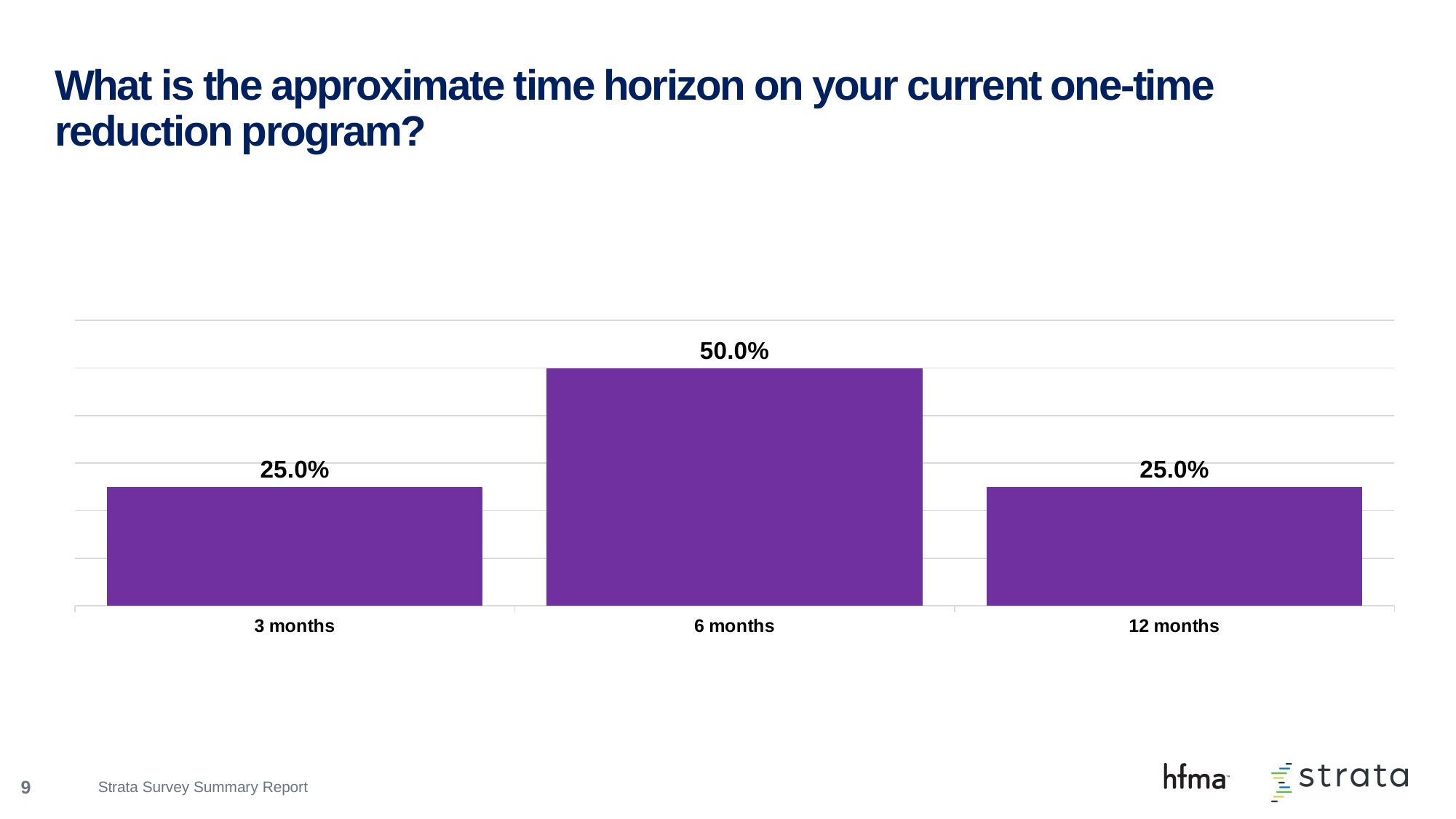
How many categories are shown on the x axis? 3 What colour are the bars in the chart? purple Which is larger, the value for 6 months or the value for 12 months? 6 months Which category has the highest value? 6 months Do the values for 3 months and 12 months differ? No, both are 25.0% What kind of chart is shown on the slide? bar chart What is the title of the slide? What is the approximate time horizon on your current one-time reduction program? What is the value for 6 months? 50.0% What is the difference between the values for 6 months and 3 months? 25.0% What is the value for 12 months? 25.0% What is the value for 3 months? 25.0% What is the total of the values for 3 months and 12 months? 50.0%